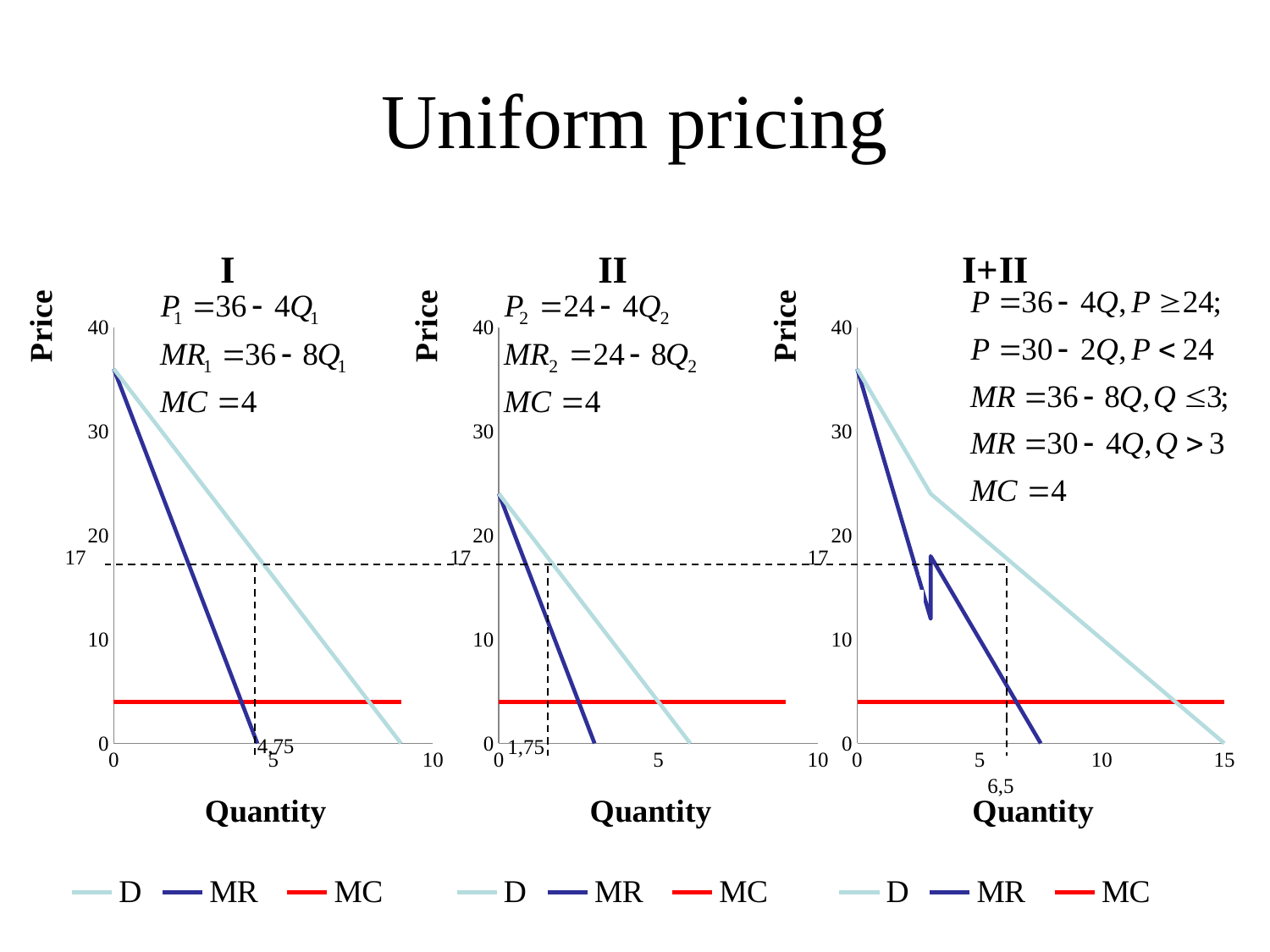
In chart I, is the MC line greater or less than 10? less What is the label of the x axis in chart II? Quantity In chart I+II, what quantity does the dashed vertical line mark on the x axis? 6,5 In chart II, what quantity does the dashed vertical line mark on the x axis? 1,75 In chart I, what quantity does the dashed vertical line mark on the x axis? 4,75 How many series does the legend of chart II list? 3 In chart II, at quantity 2, which line is higher, D or MR? D What kind of chart is chart I? line chart In chart I, what price does the dashed horizontal line mark on the y axis? 17 In chart I+II, is the value of the D line at quantity 5 greater or less than 10? greater What is the highest tick value on the x axis of chart I+II? 15 In chart I, does the D line rise or fall as quantity increases? fall